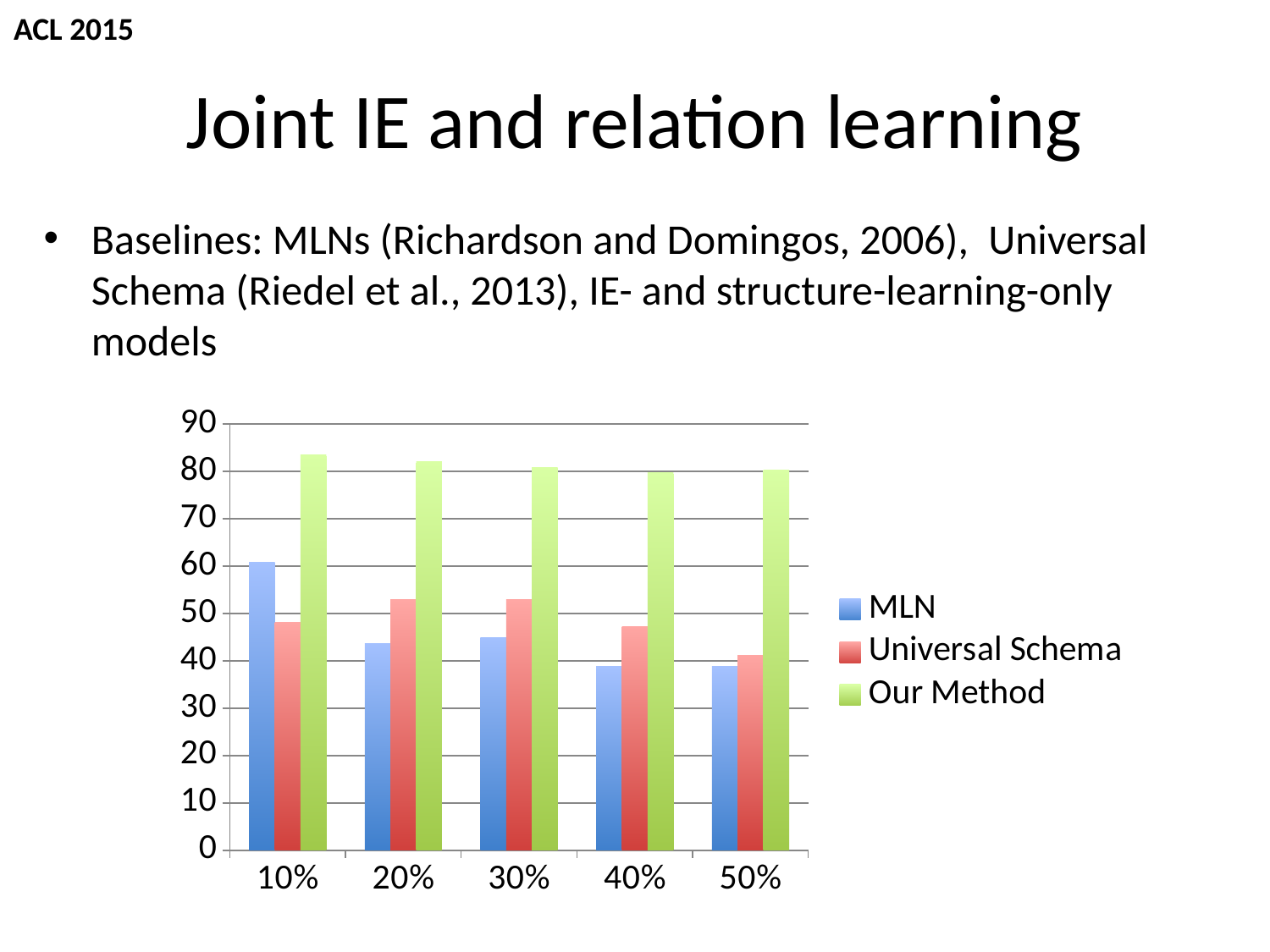
What kind of chart is shown on the slide? bar chart Is the value for MLN at 40% greater or less than 50? less Which series has the highest value at the 10% category? Our Method At the 20% category, which is larger: MLN or Universal Schema? Universal Schema How many categories are shown on the x axis? 5 At which category is the Universal Schema series lowest? 50% Do the values for Our Method rise or fall from 10% to 50%? fall At which category is the MLN series highest? 10% At the 10% category, which is larger: MLN or Universal Schema? MLN Is the value for Our Method at 10% greater or less than 80? greater How many series does the legend list? 3 Is the value for Universal Schema at 50% greater or less than 50? less